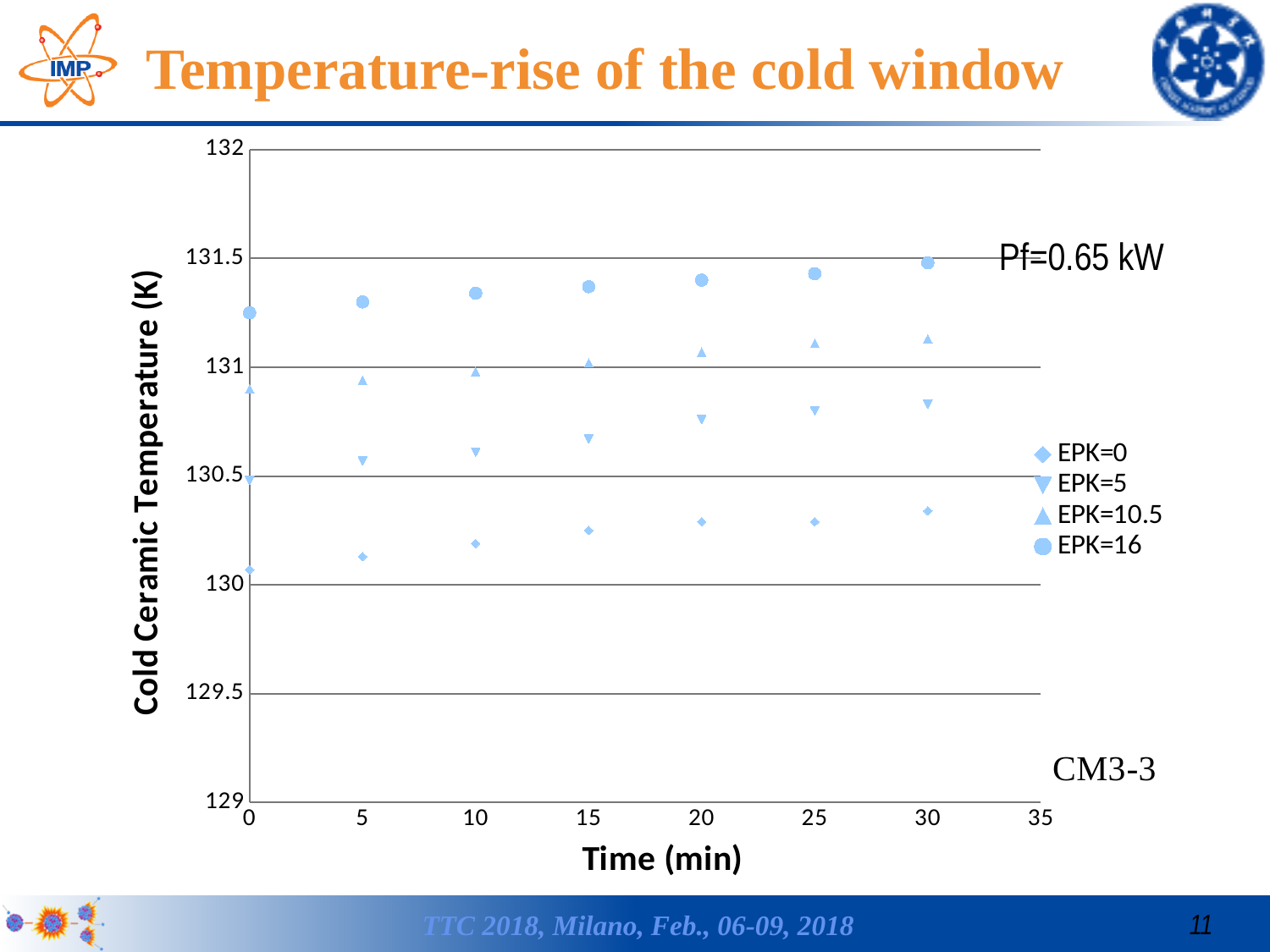
Is the EPK=16 value at 30 min greater or less than 131? greater What kind of chart is shown on the slide? Scatter chart Is the EPK=5 value at 30 min greater or less than 131? less At 30 min, which is larger: the EPK=10.5 value or the EPK=5 value? EPK=10.5 What is the title of the x axis? Time (min) Do the EPK=16 temperature values rise or fall as time increases? Rise How many data points are plotted for the EPK=16 series? 7 Which series has the highest cold ceramic temperature at 30 min? EPK=16 Which series has the lowest cold ceramic temperature at 30 min? EPK=0 What forward power is annotated on the chart? Pf=0.65 kW How many series does the legend list? 4 Is the EPK=0 value at 0 min greater or less than 130.5? less